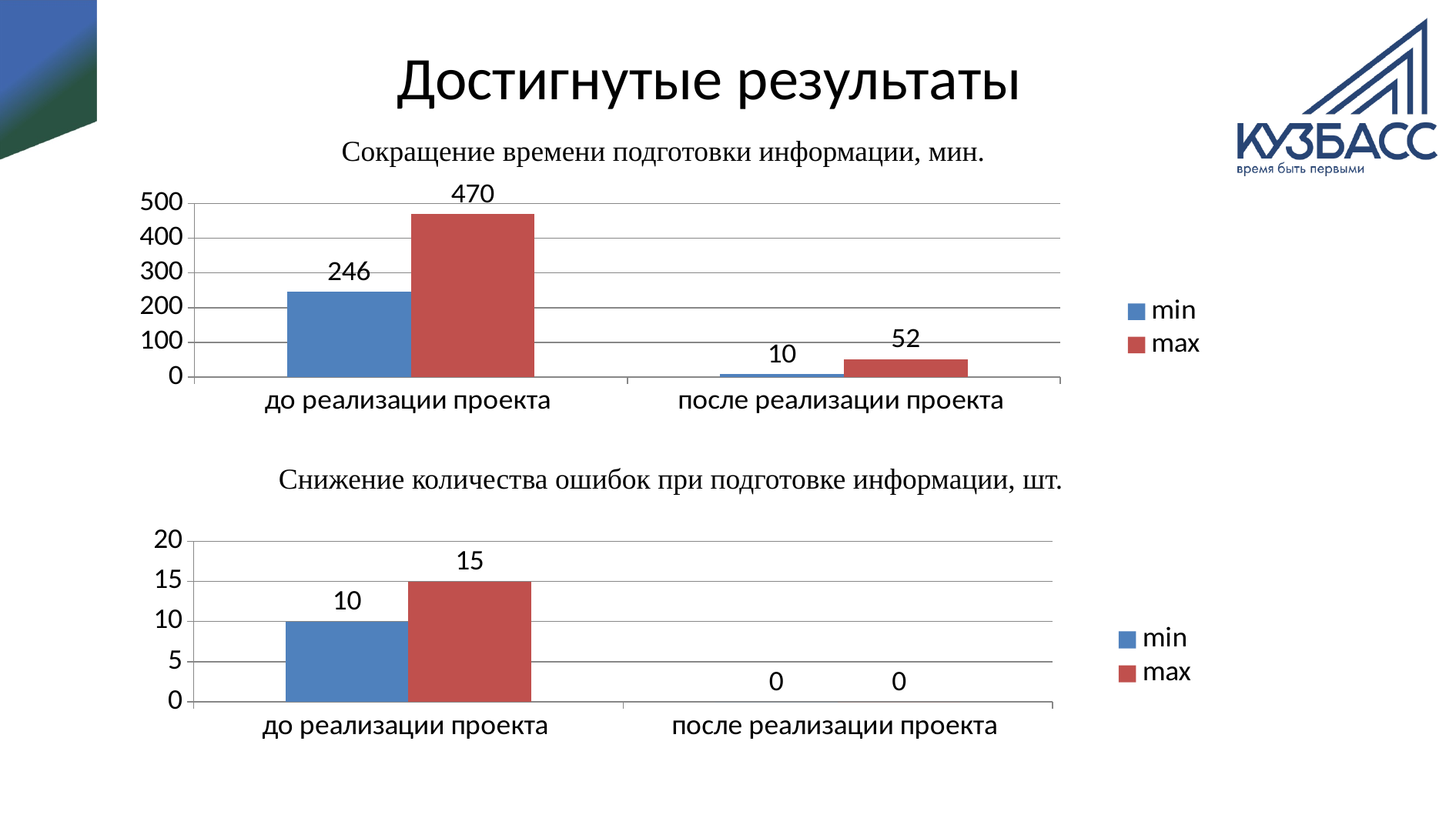
In the top chart 'Сокращение времени подготовки информации, мин.', which colour represents the 'max' series? red In the top chart 'Сокращение времени подготовки информации, мин.', how many series does the legend list? 2 In the top chart 'Сокращение времени подготовки информации, мин.', is the max value for 'после реализации проекта' greater or less than 100? less What kind of chart is the bottom chart 'Снижение количества ошибок при подготовке информации, шт.'? bar chart In the bottom chart 'Снижение количества ошибок при подготовке информации, шт.', what is the max value for 'до реализации проекта'? 15 In the top chart 'Сокращение времени подготовки информации, мин.', which category has the highest max value? до реализации проекта In the bottom chart 'Снижение количества ошибок при подготовке информации, шт.', what is the difference between the max and min values for 'до реализации проекта'? 5 In the top chart 'Сокращение времени подготовки информации, мин.', what is the min value for 'после реализации проекта'? 10 In the bottom chart 'Снижение количества ошибок при подготовке информации, шт.', what is the min value for 'после реализации проекта'? 0 In the bottom chart 'Снижение количества ошибок при подготовке информации, шт.', how many categories are shown on the x axis? 2 In the top chart 'Сокращение времени подготовки информации, мин.', what is the difference between the max and min values for 'до реализации проекта'? 224 In the top chart 'Сокращение времени подготовки информации, мин.', what is the max value for 'до реализации проекта'? 470